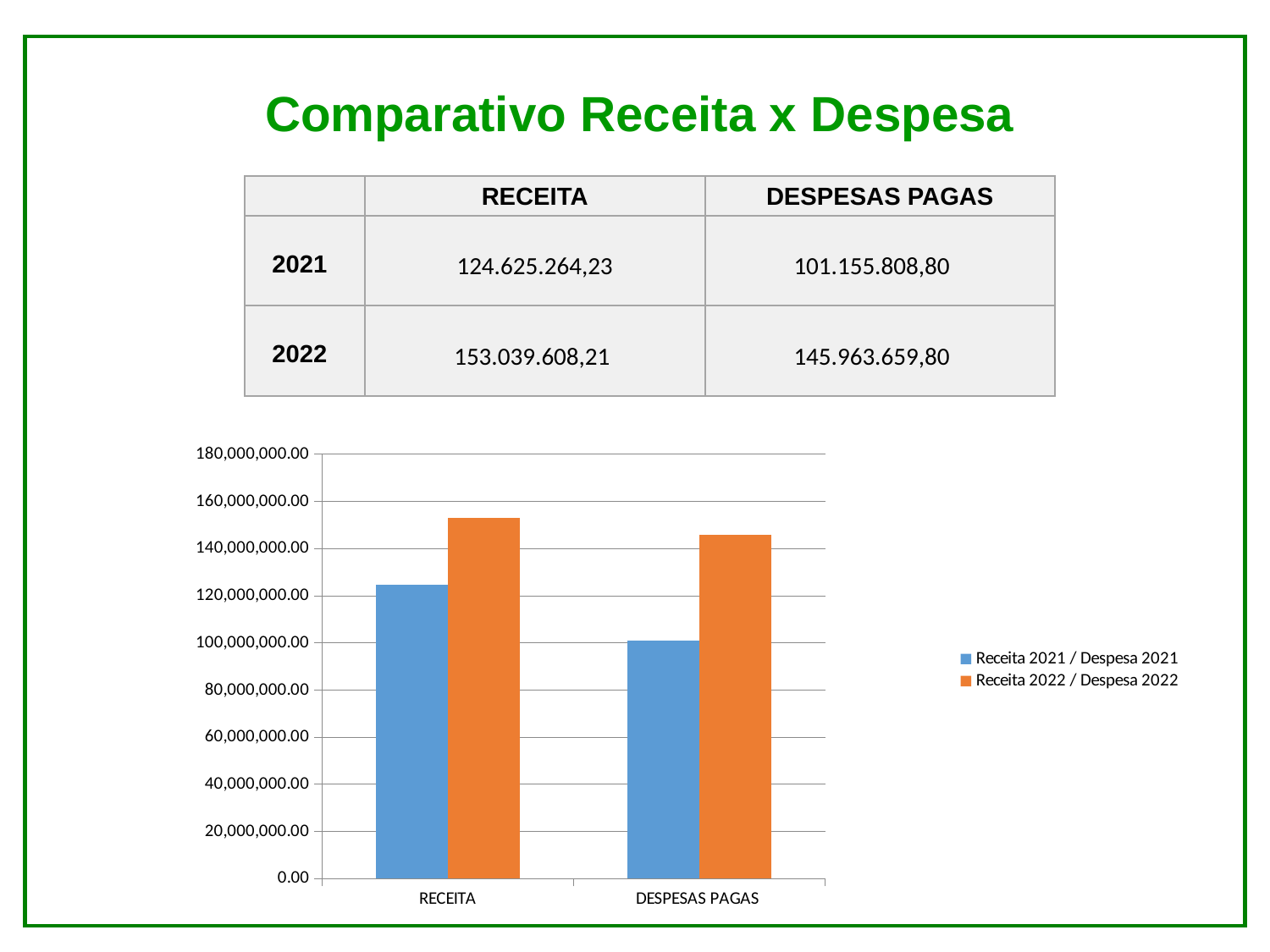
In the chart, which is larger: RECEITA for 2021 or DESPESAS PAGAS for 2022? DESPESAS PAGAS for 2022 How many series does the chart legend list? 2 What are the two category labels on the x axis of the chart? RECEITA and DESPESAS PAGAS According to the table on the slide, what is the RECEITA value for 2022? 153.039.608,21 In the chart, is the RECEITA bar for 2022 greater or less than 140,000,000.00? greater Which series is shown in orange in the chart? Receita 2022 / Despesa 2022 Which bar is the tallest in the chart? RECEITA for Receita 2022 / Despesa 2022 How many categories are shown on the x axis of the chart? 2 In the chart, is the RECEITA bar for 2021 greater or less than 120,000,000.00? greater In the chart, is the DESPESAS PAGAS bar for 2022 greater or less than 160,000,000.00? less Which bar is the shortest in the chart? DESPESAS PAGAS for Receita 2021 / Despesa 2021 What kind of chart is shown on the slide? bar chart